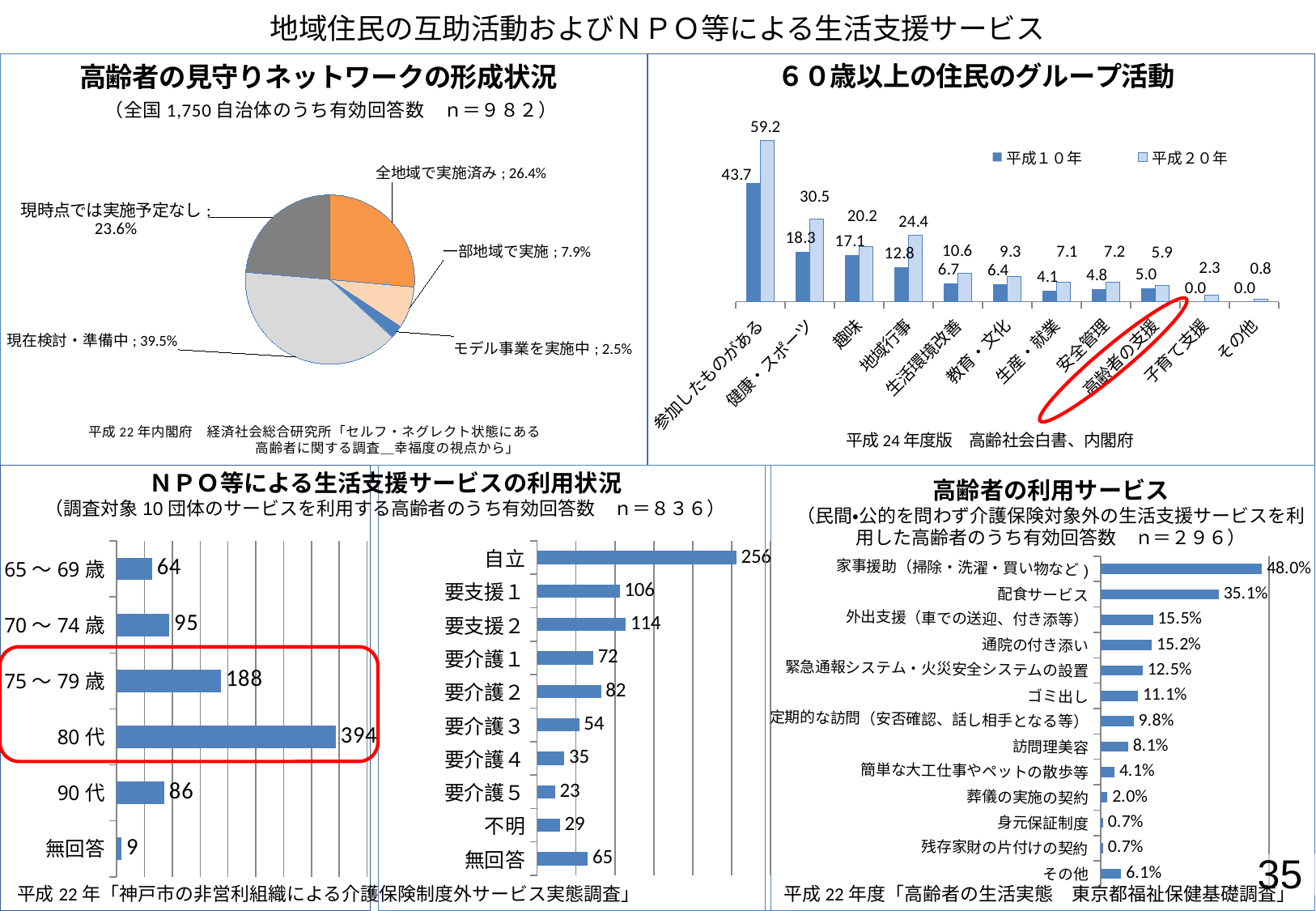
In the chart titled ６０歳以上の住民のグループ活動, what is the difference between the 平成２０年 and 平成１０年 values for 健康・スポーツ? 12.2 In the chart titled ６０歳以上の住民のグループ活動, what is the 平成２０年 value for 地域行事? 24.4 In the pie chart titled 高齢者の見守りネットワークの形成状況, which slice is the smallest? モデル事業を実施中 In the chart titled ６０歳以上の住民のグループ活動, how many series does the legend list? 2 What kind of chart is the one titled 高齢者の利用サービス? bar chart In the chart titled 高齢者の利用サービス, what is the value for 配食サービス? 35.1% In the age-group bar chart under ＮＰＯ等による生活支援サービスの利用状況, which age group has the highest value? 80代 In the age-group bar chart under ＮＰＯ等による生活支援サービスの利用状況, what is the value for 75～79歳? 188 In the care-level bar chart under ＮＰＯ等による生活支援サービスの利用状況, what is the value for 要介護５? 23 In the chart titled ６０歳以上の住民のグループ活動, what is the 平成１０年 value for 高齢者の支援? 5.0 In the pie chart titled 高齢者の見守りネットワークの形成状況, what share is labelled 現在検討・準備中? 39.5% In the care-level bar chart under ＮＰＯ等による生活支援サービスの利用状況, which is larger, 要支援１ or 要支援２? 要支援２